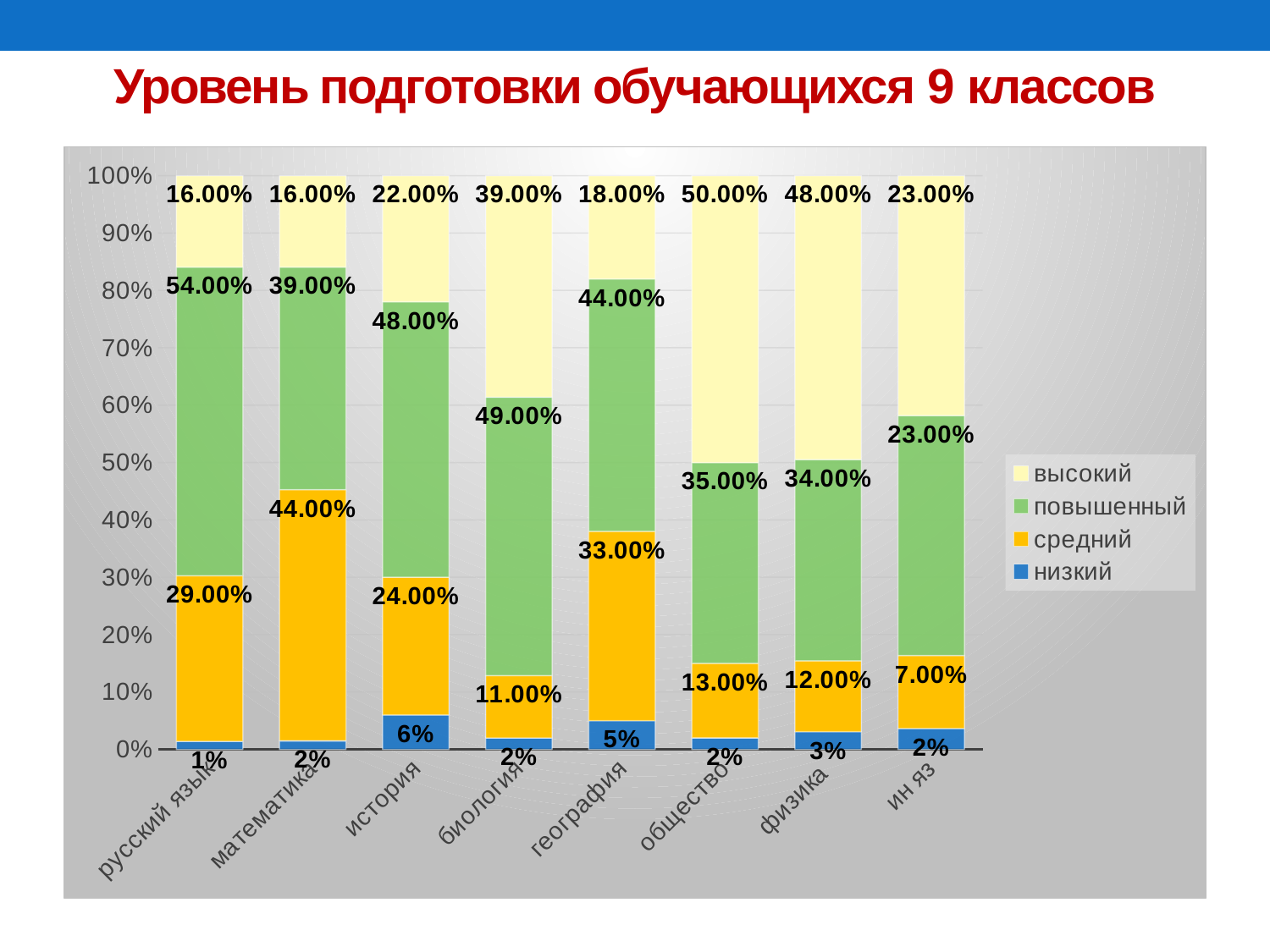
How many subject categories are shown on the x axis? 8 What is the value of the 'средний' series for математика? 44.00% What is the difference between the 'высокий' values for биология and география? 21.00% Which subject has the lowest value for the 'средний' series? ин яз How many series does the legend list? 4 Which is larger: the 'повышенный' value for история or for физика? история What is the title of the chart on the slide? Уровень подготовки обучающихся 9 классов What kind of chart is shown on the slide? stacked bar chart What is the value of the 'низкий' series for история? 6% What is the value of the 'высокий' series for общество? 50.00% What is the value of the 'повышенный' series for русский язык? 54.00% Which subject has the highest value for the 'высокий' series? общество